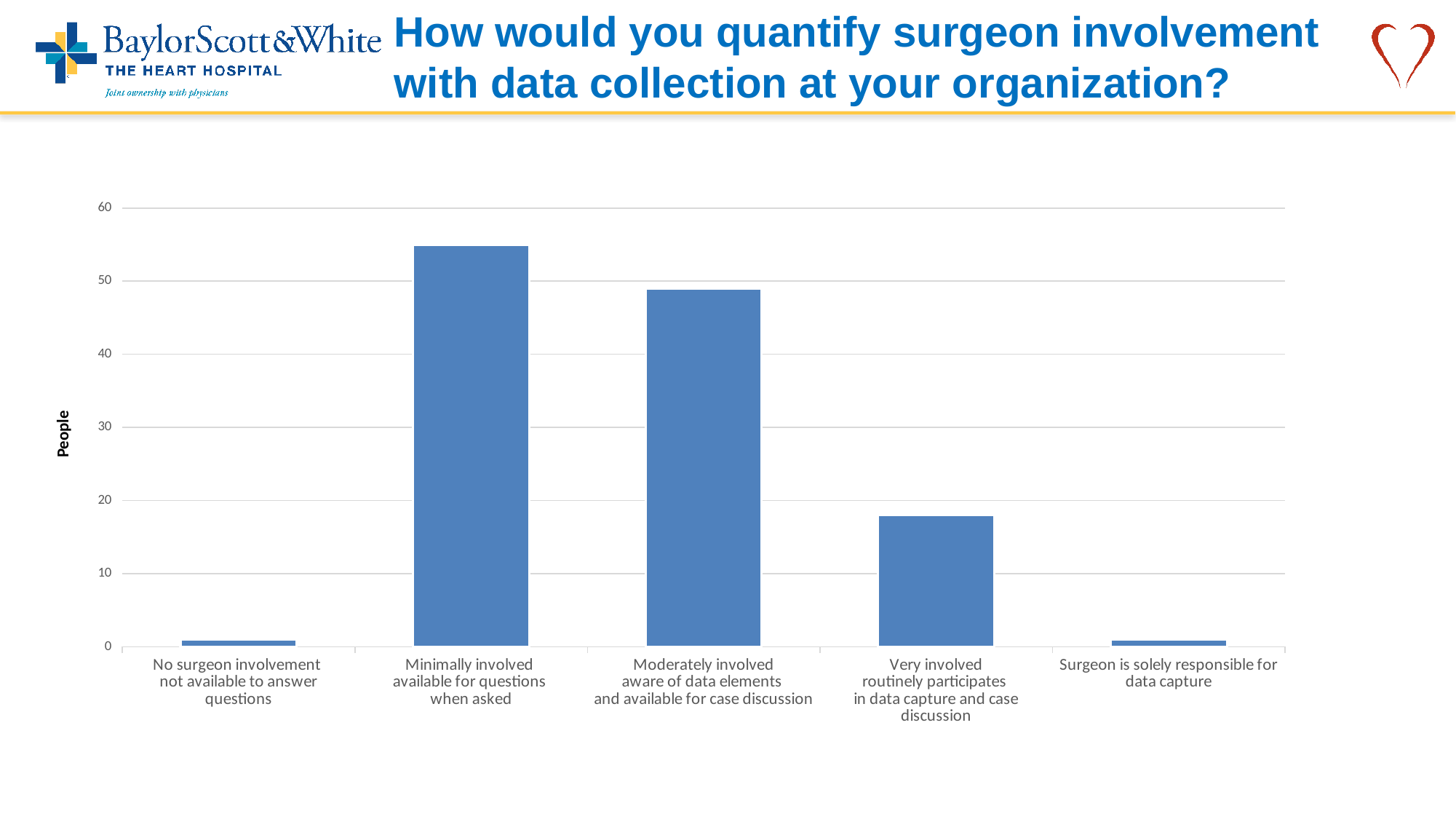
What is the highest value shown on the vertical axis of the chart? 60 How many categories are shown on the x axis of the chart? 5 Is the value for 'Minimally involved available for questions when asked' greater or less than 50? greater Which is larger: the value for 'Minimally involved' or the value for 'Moderately involved'? Minimally involved What is the label on the vertical axis of the chart? People Which is larger: the value for 'Very involved' or the value for 'Moderately involved'? Moderately involved Is the value for 'Moderately involved aware of data elements and available for case discussion' greater or less than 40? greater Is the value for 'Very involved routinely participates in data capture and case discussion' greater or less than 20? less What kind of chart is shown on the slide? bar chart Which category has the highest bar in the chart? Minimally involved available for questions when asked